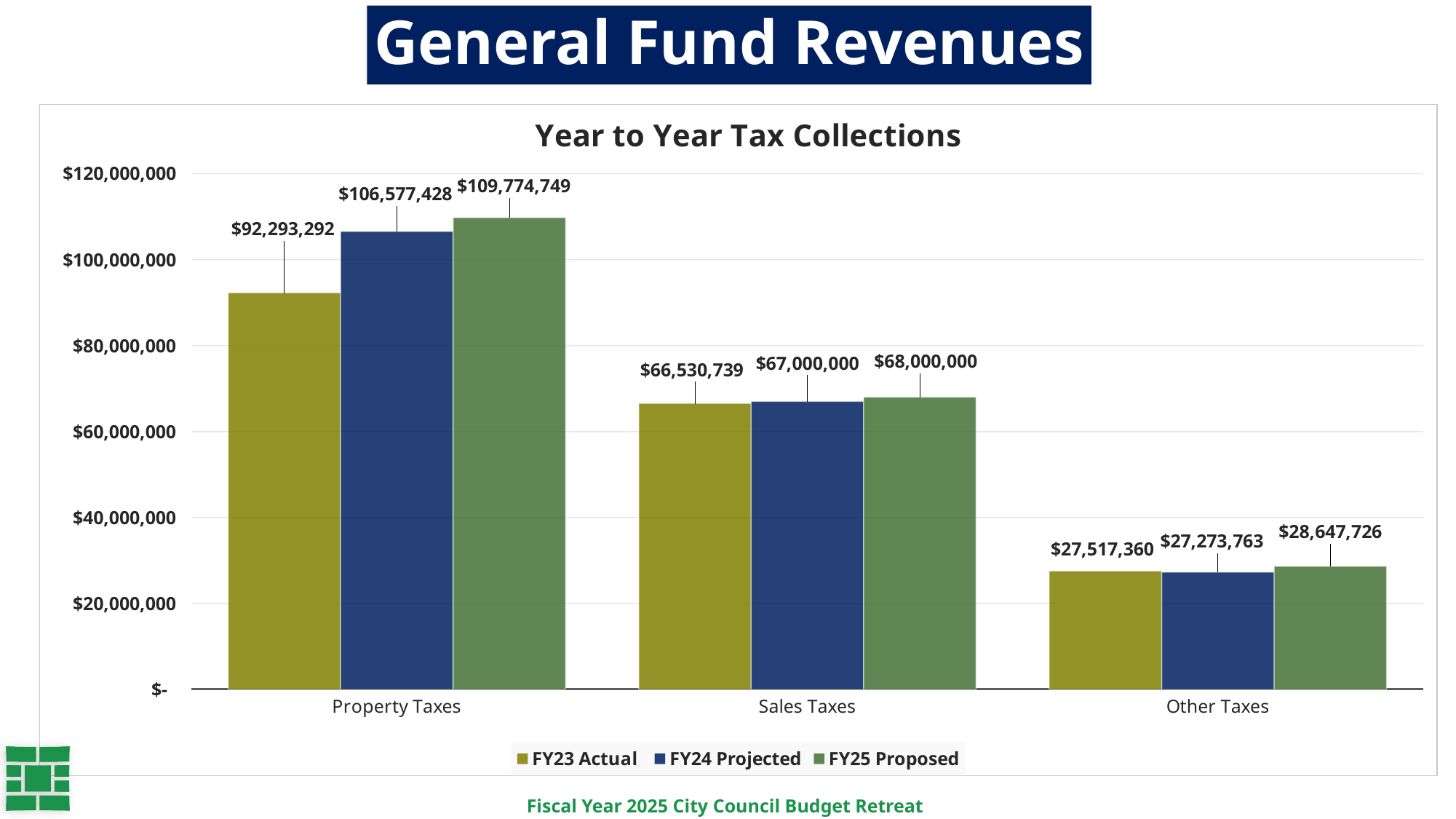
Is the FY24 Projected value for Property Taxes greater or less than $100,000,000? greater What is the difference between the FY25 Proposed and FY24 Projected values for Property Taxes? $3,197,321 Which category has the lowest FY23 Actual value? Other Taxes What is the FY25 Proposed value for Sales Taxes? $68,000,000 What is the difference between the FY25 Proposed and FY23 Actual values for Sales Taxes? $1,469,261 What is the FY24 Projected value for Other Taxes? $27,273,763 What is the FY23 Actual value for Property Taxes? $92,293,292 Which category has the highest FY25 Proposed value? Property Taxes For Other Taxes, which is larger: the FY23 Actual value or the FY24 Projected value? FY23 Actual How many categories are shown on the x axis? 3 What kind of chart is shown on the slide? Bar chart How many series does the legend list? 3